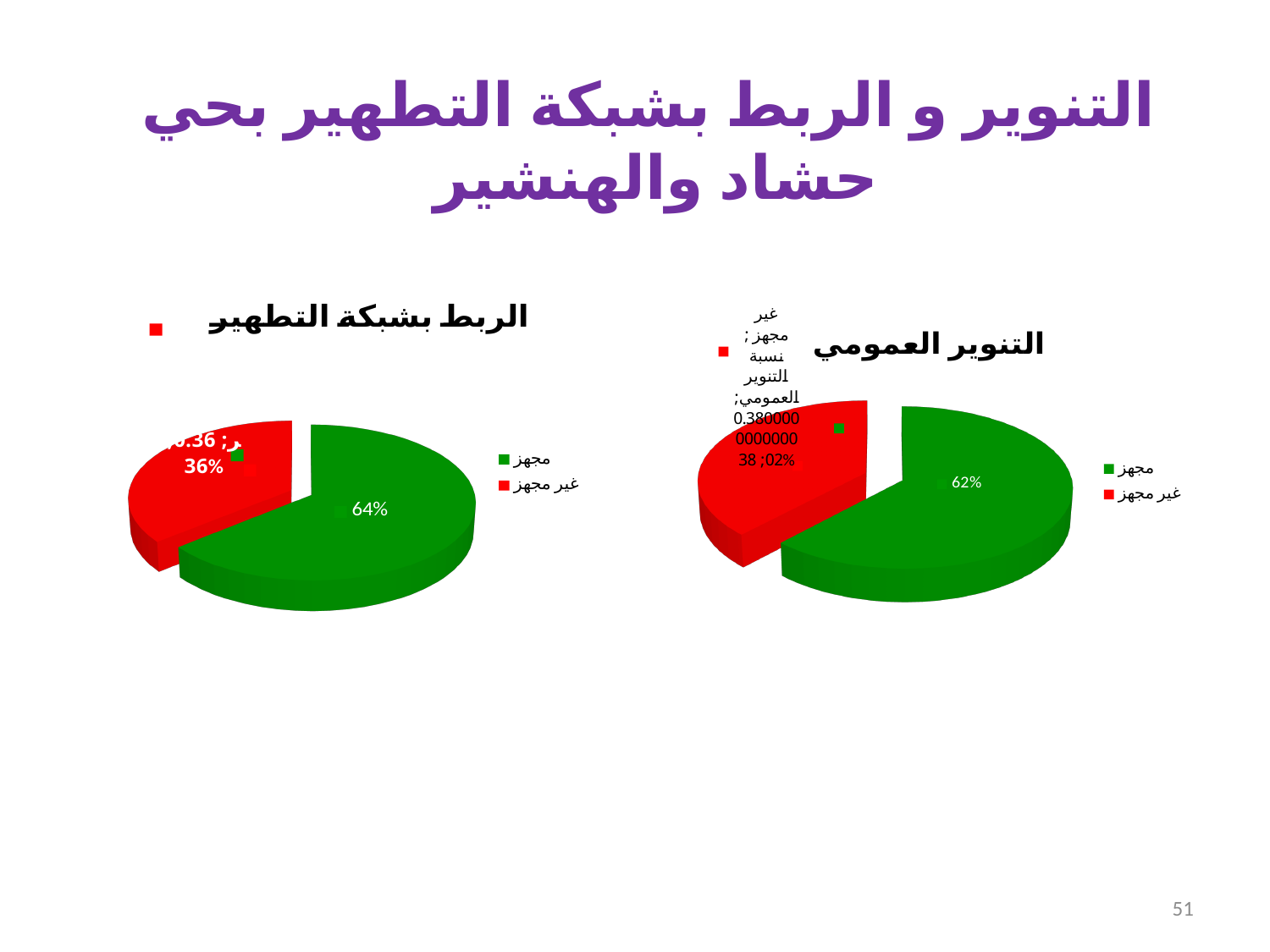
Which chart on the slide shows a value of 64% for مجهز: the left chart or the right chart? The left chart (الربط بشبكة التطهير) In the chart titled التنوير العمومي, what colour is the slice for غير مجهز? Red In the chart titled الربط بشبكة التطهير, which category has the largest slice? مجهز In the chart titled التنوير العمومي, what percentage is shown for مجهز? 62% How many entries does the legend of the chart titled الربط بشبكة التطهير list? 2 In the chart titled الربط بشبكة التطهير, what is the difference in percentage points between مجهز and غير مجهز? 28 In the chart titled الربط بشبكة التطهير, what percentage is shown for غير مجهز? 36% What type of chart is the chart titled الربط بشبكة التطهير? Pie chart In the chart titled الربط بشبكة التطهير, what percentage is shown for مجهز? 64% How many slices does the chart titled التنوير العمومي have? 2 Which is larger in the chart titled التنوير العمومي: the slice for مجهز or the slice for غير مجهز? مجهز In the chart titled التنوير العمومي, which category has the smallest slice? غير مجهز